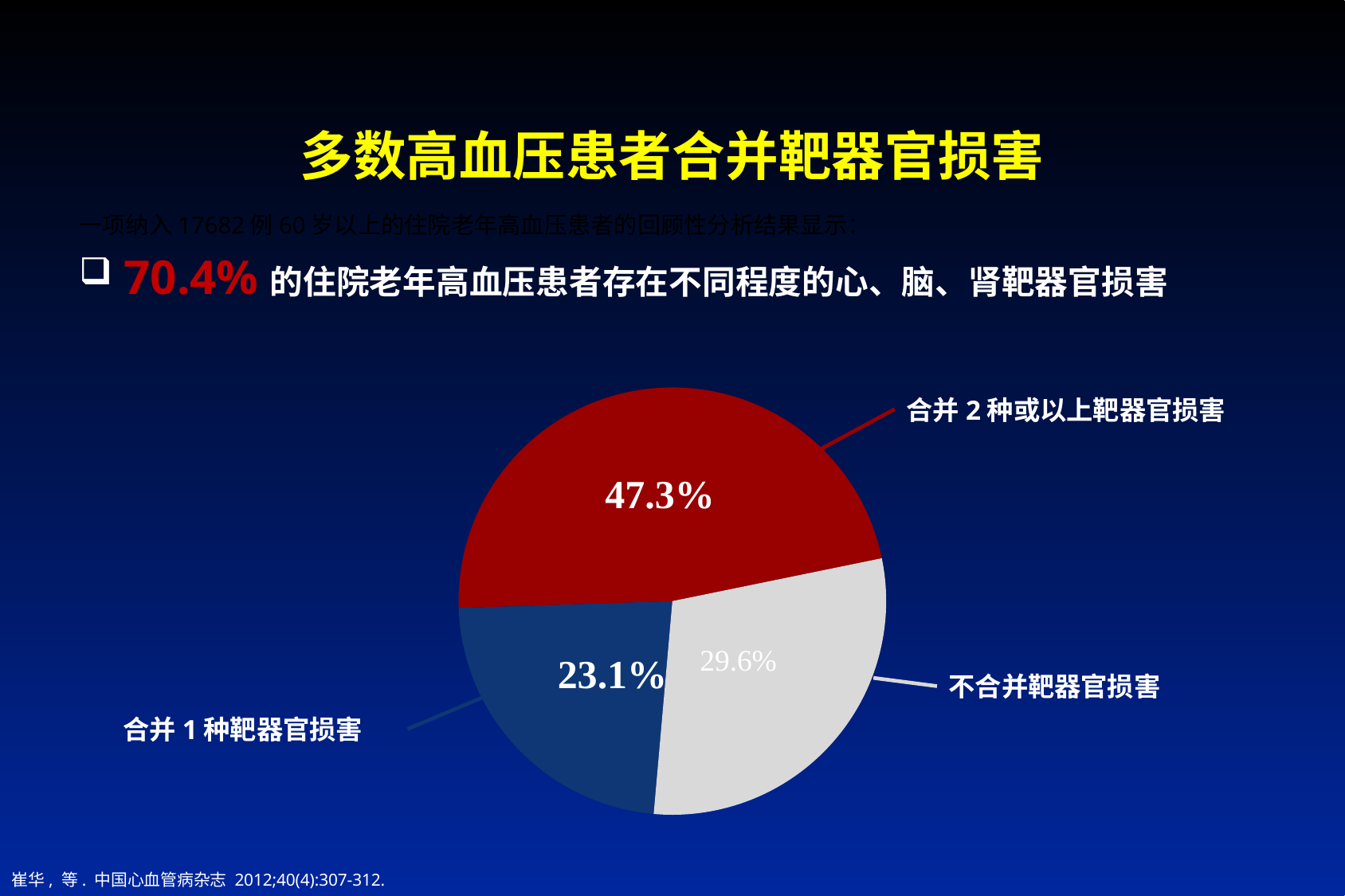
What colour is the slice for 合并 1 种靶器官损害? blue Which category has the largest slice of the pie? 合并 2 种或以上靶器官损害 What is the share for 合并 1 种靶器官损害? 23.1% How many slices does the pie chart have? 3 What colour is the slice for 合并 2 种或以上靶器官损害? red Which category has the smallest slice of the pie? 合并 1 种靶器官损害 What kind of chart is shown on the slide? pie chart Which is larger, the share for 不合并靶器官损害 or the share for 合并 1 种靶器官损害? 不合并靶器官损害 What is the difference between the shares for 不合并靶器官损害 and 合并 1 种靶器官损害? 6.5% What is the share for 不合并靶器官损害? 29.6% What is the share for 合并 2 种或以上靶器官损害? 47.3% What is the difference between the shares for 合并 2 种或以上靶器官损害 and 不合并靶器官损害? 17.7%